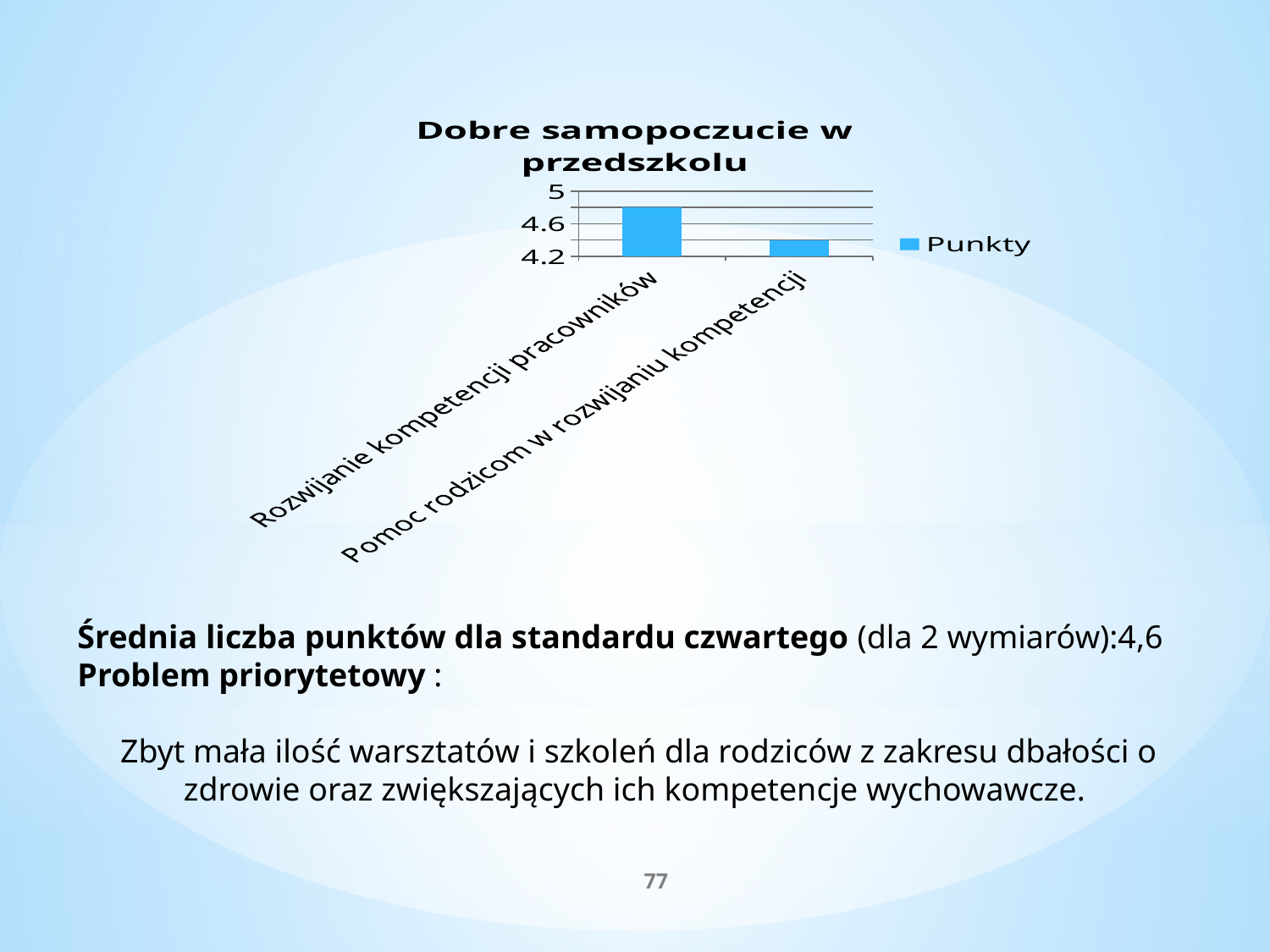
Is the value for Pomoc rodzicom w rozwijaniu kompetencji greater or less than 4.6? less How many series does the chart legend list? 1 Is the value for Rozwijanie kompetencji pracowników greater or less than 5? less How many categories are shown on the x axis of the chart? 2 Which category has the lowest value in the chart? Pomoc rodzicom w rozwijaniu kompetencji Which is larger: the value for Rozwijanie kompetencji pracowników or the value for Pomoc rodzicom w rozwijaniu kompetencji? Rozwijanie kompetencji pracowników What kind of chart is shown on the slide? bar chart What is the title of the chart? Dobre samopoczucie w przedszkolu What is the name of the series shown in the chart legend? Punkty Do the values rise or fall from the first category to the second along the x axis? fall Is the value for Rozwijanie kompetencji pracowników greater or less than 4.6? greater Which category has the highest value in the chart? Rozwijanie kompetencji pracowników